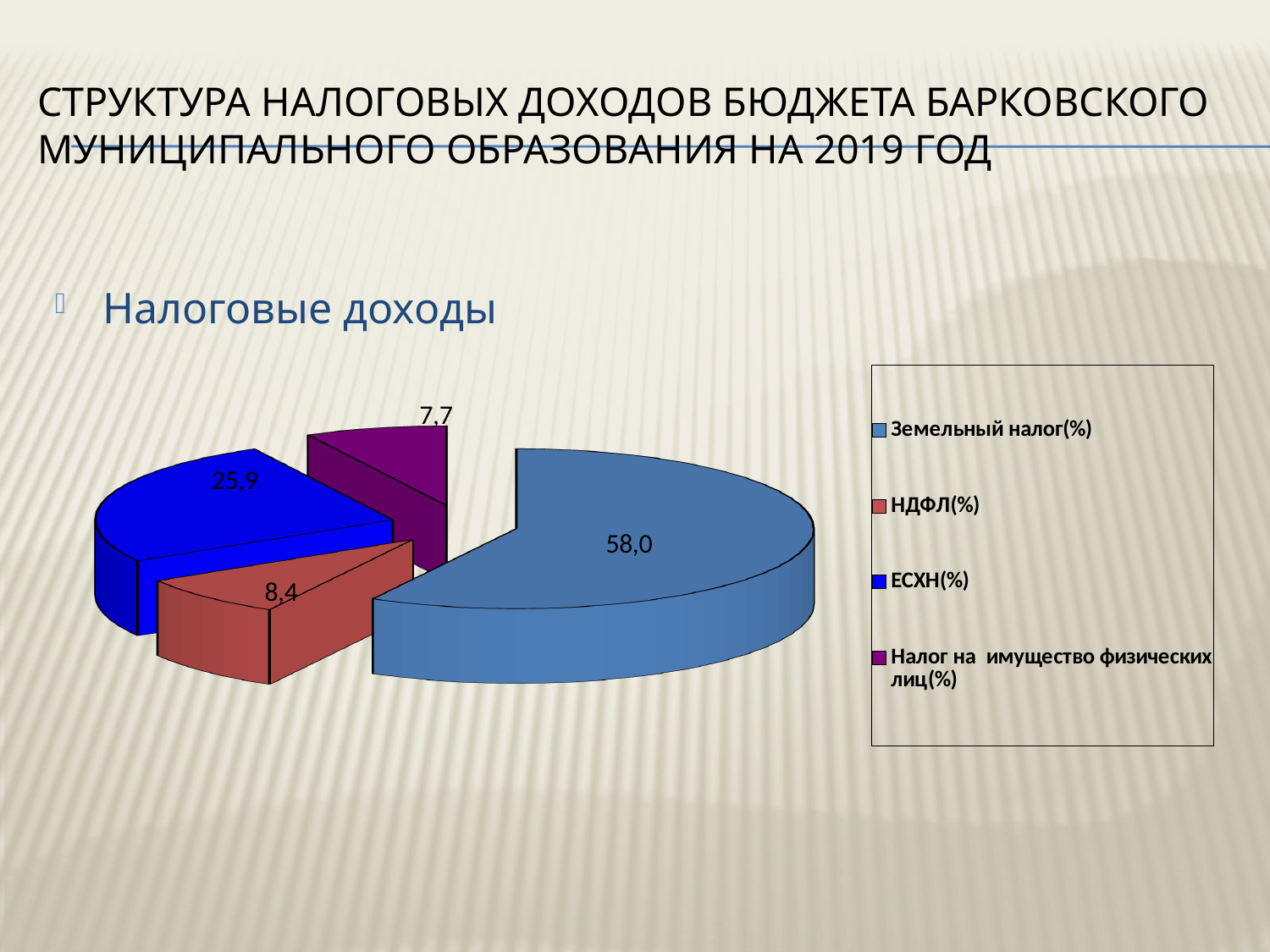
What is the value for НДФЛ(%)? 8,4 What is the value for Налог на имущество физических лиц(%)? 7,7 Which category has the largest slice of the pie? Земельный налог(%) What is the difference between the values for Земельный налог(%) and ЕСХН(%)? 32,1 How many entries does the legend list? 4 What colour is the slice for ЕСХН(%)? blue What is the value for ЕСХН(%)? 25,9 Which is larger, the value for НДФЛ(%) or the value for ЕСХН(%)? ЕСХН(%) Which category has the smallest slice of the pie? Налог на имущество физических лиц(%) What kind of chart is shown on the slide? pie chart How many slices does the pie chart have? 4 What is the value for Земельный налог(%)? 58,0